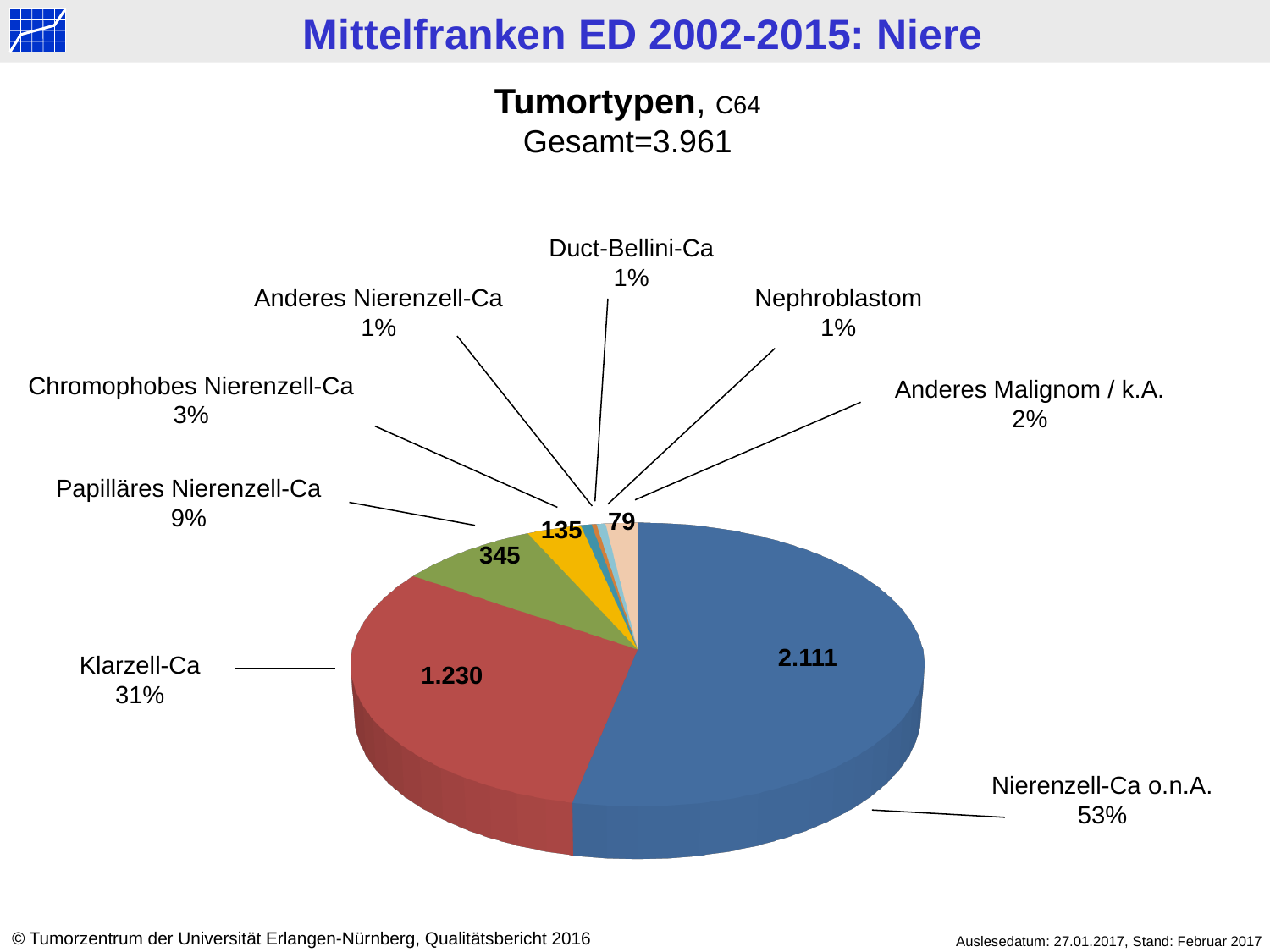
What total (Gesamt) is stated above the pie chart? 3.961 What is the title of the pie chart? Tumortypen, C64 What percentage share is shown for Papilläres Nierenzell-Ca? 9% Which tumour type has the largest slice of the pie? Nierenzell-Ca o.n.A. What kind of chart is shown on the slide? pie chart What is the number of cases shown for Klarzell-Ca? 1.230 What percentage share is shown for Anderes Malignom / k.A.? 2% How many tumour type categories are shown in the pie chart? 8 What is the number of cases shown for Chromophobes Nierenzell-Ca? 135 What share of the pie does Nierenzell-Ca o.n.A. account for? 53% What is the difference between the number of cases for Nierenzell-Ca o.n.A. and Klarzell-Ca? 881 Which has a larger share, Papilläres Nierenzell-Ca or Chromophobes Nierenzell-Ca? Papilläres Nierenzell-Ca